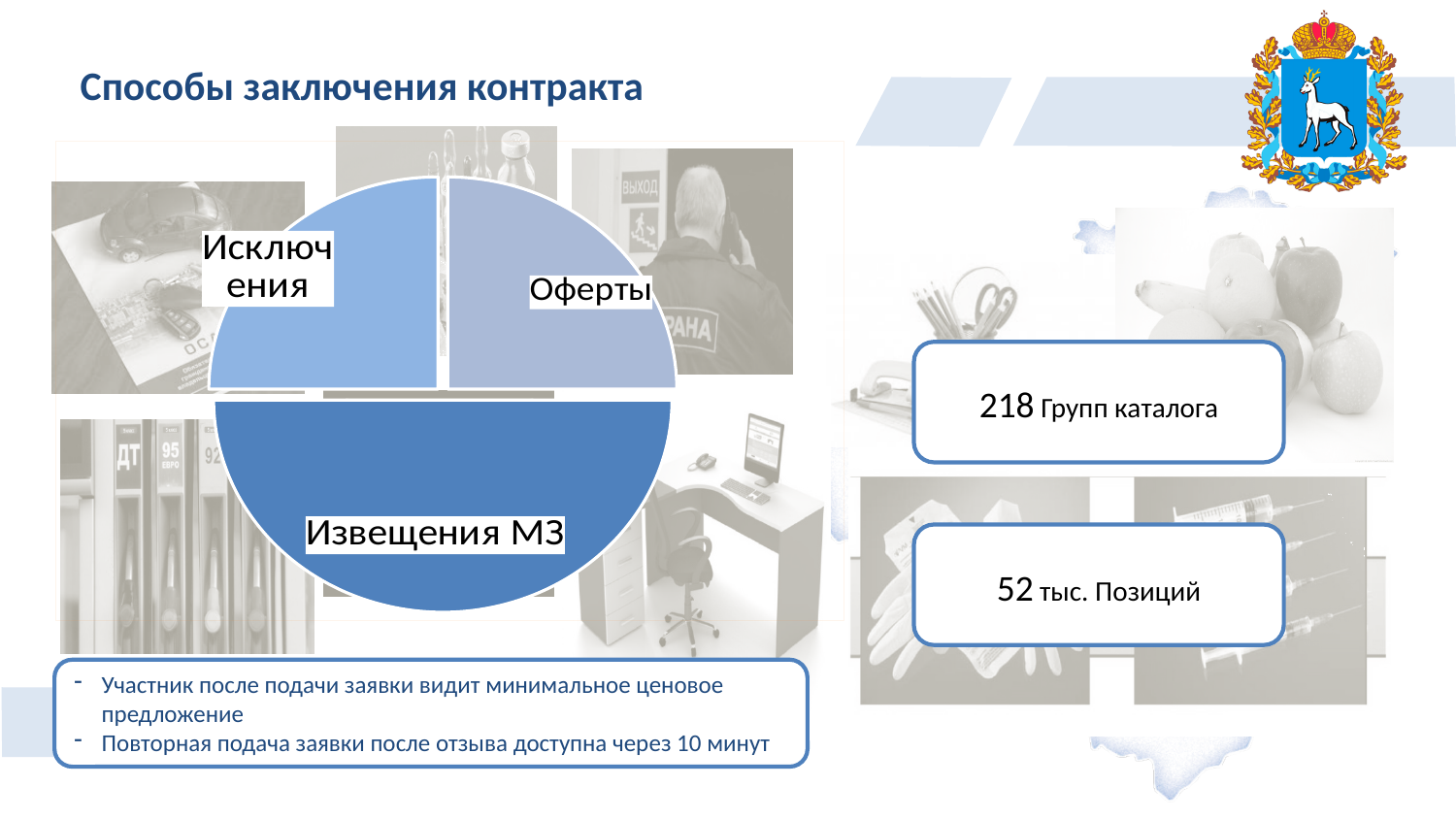
What are the labels of the three slices in the pie chart? Исключения, Оферты, Извещения МЗ What kind of chart is shown on the slide? pie chart Which slice of the pie chart is the largest? Извещения МЗ Which slice of the pie chart is drawn in the darkest blue? Извещения МЗ Does the slice for Извещения МЗ take up more or less than a quarter of the pie chart? more Which is larger in the pie chart, the slice for Извещения МЗ or the slice for Исключения? Извещения МЗ How many slices does the pie chart have? 3 Which is larger in the pie chart, the slice for Извещения МЗ or the slice for Оферты? Извещения МЗ